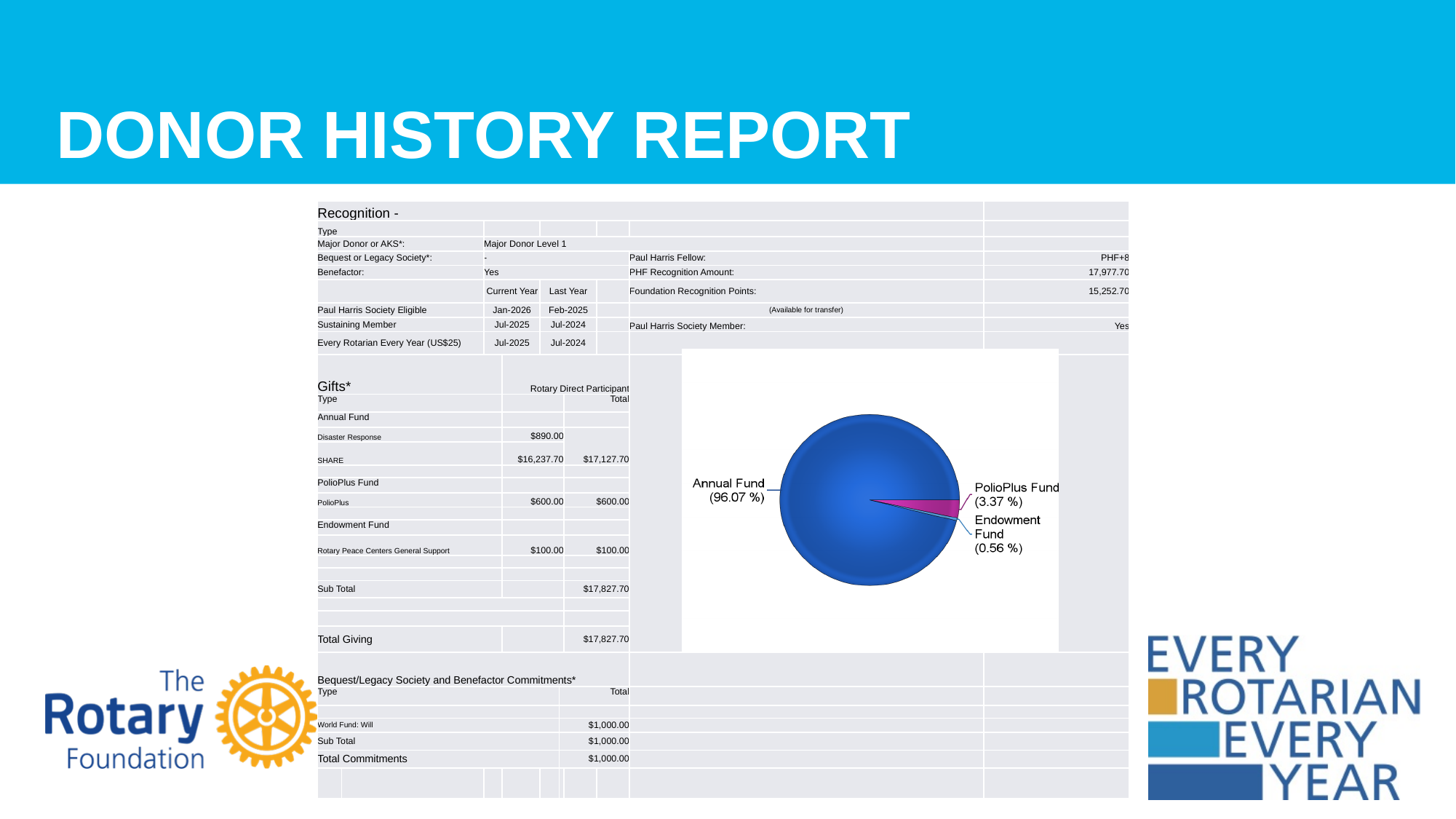
What share of the pie chart does the Endowment Fund slice represent? 0.56 % What share of the pie chart does the Annual Fund slice represent? 96.07 % What kind of chart is shown on the slide? pie chart Which is larger in the pie chart, the PolioPlus Fund slice or the Endowment Fund slice? PolioPlus Fund Which slice of the pie chart is the largest? Annual Fund Is the Annual Fund share in the pie chart greater or less than 90 %? greater Which slice of the pie chart is the smallest? Endowment Fund How many slices does the pie chart have? 3 By how many percentage points does the PolioPlus Fund share exceed the Endowment Fund share in the pie chart? 2.81 % What colour is the PolioPlus Fund slice in the pie chart? magenta (pink) What share of the pie chart does the PolioPlus Fund slice represent? 3.37 % By how many percentage points does the Annual Fund share exceed the PolioPlus Fund share in the pie chart? 92.70 %